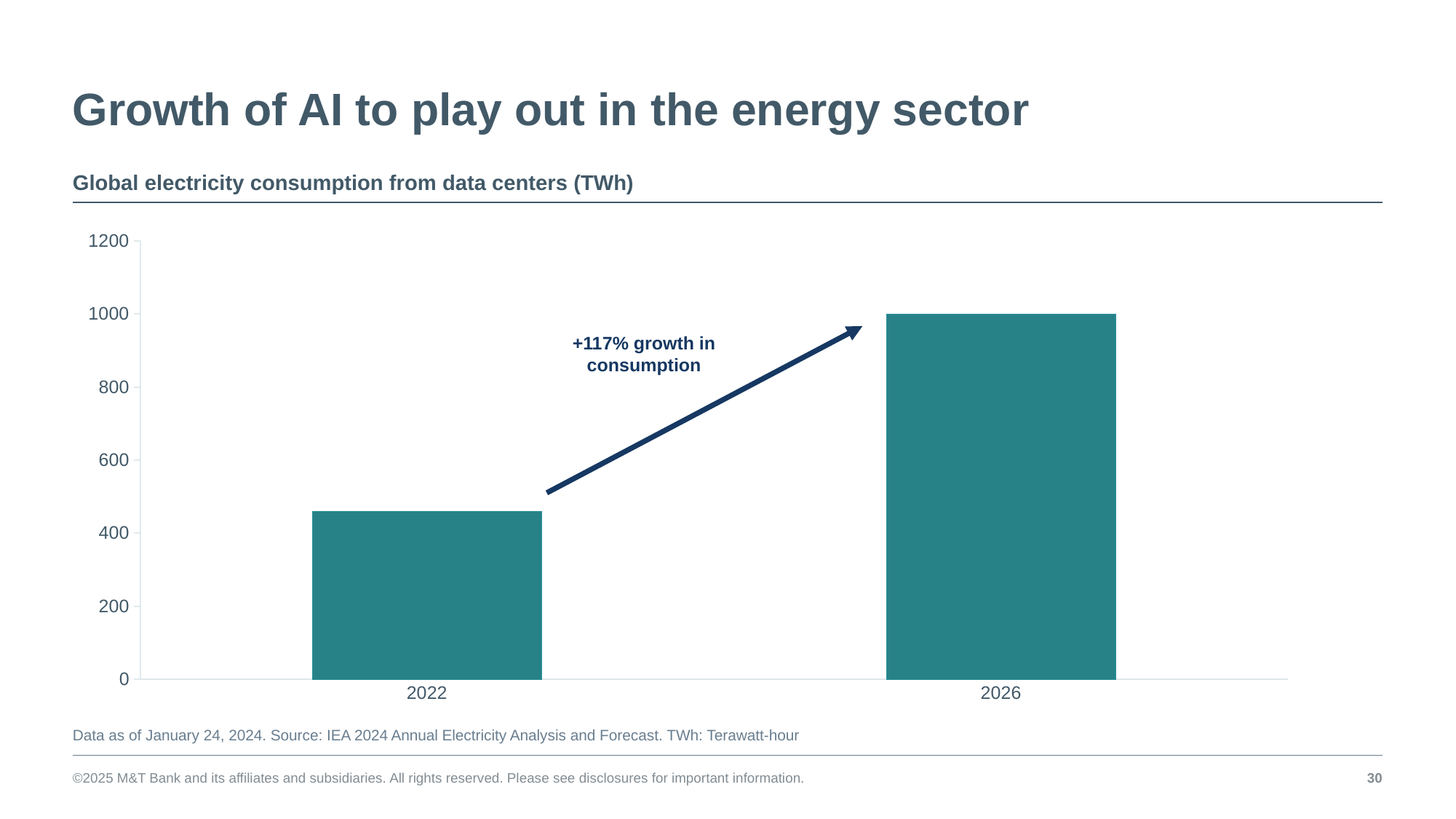
What percentage growth in consumption does the arrow annotation on the chart state? +117% Which is larger, the value for 2022 or the value for 2026? 2026 Which year has the highest global electricity consumption from data centers? 2026 Is the value for 2022 greater or less than 400? greater Do the values rise or fall from 2022 to 2026? rise What kind of chart is shown on the slide? bar chart How many bars (years) are plotted in the chart? 2 Is the value for 2026 greater or less than 800? greater What is the title of the chart? Global electricity consumption from data centers (TWh) What is the global electricity consumption from data centers in 2026, in TWh? 1000 Is the value for 2022 greater or less than 600? less Which year has the lowest global electricity consumption from data centers? 2022